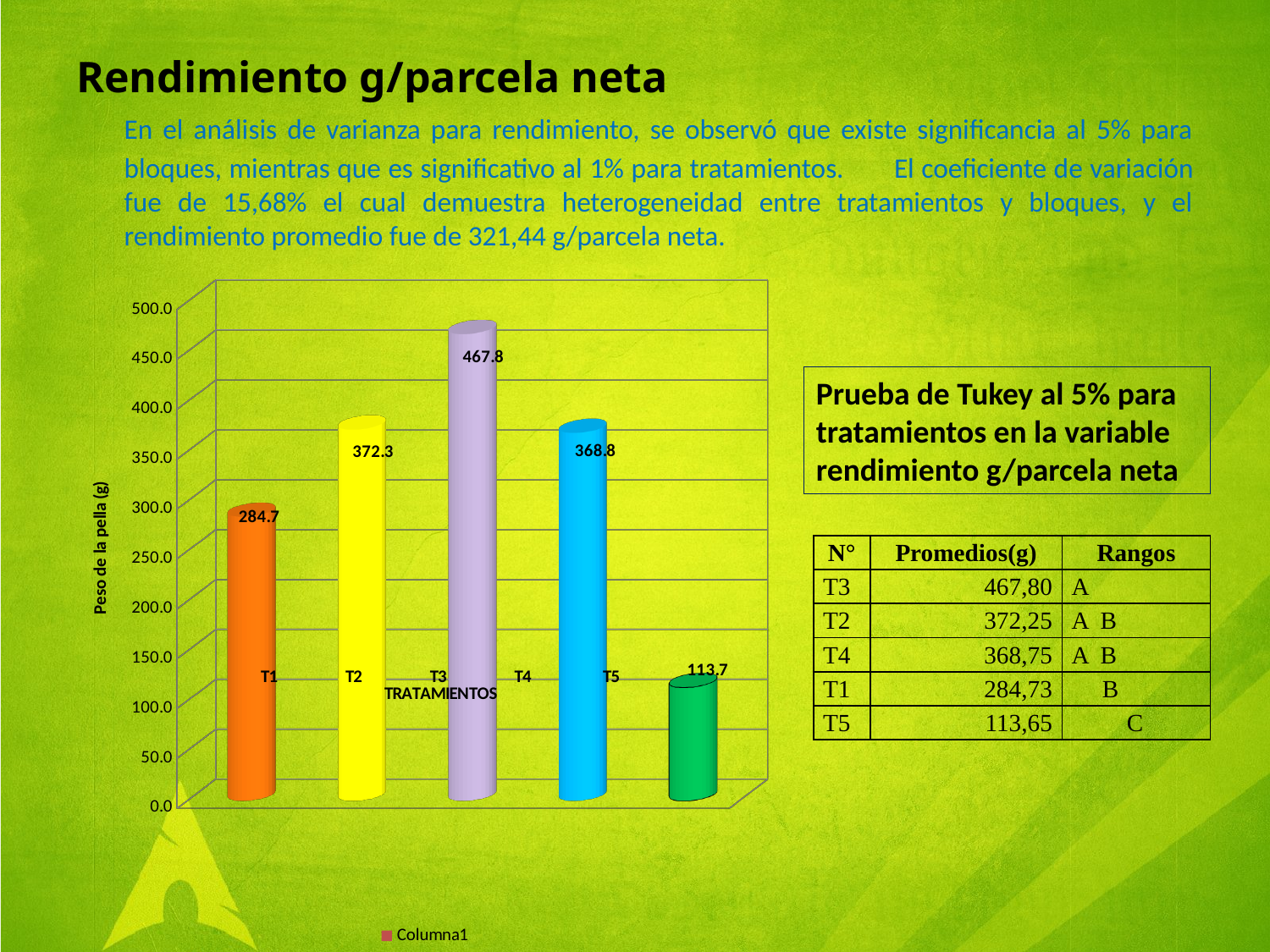
What is the difference between the values for T3 and T5? 354.1 What kind of chart is shown on the slide? bar chart Which is larger, the value for T1 or the value for T4? T4 What is the label of the y axis? Peso de la pella (g) What is the value for T1? 284.7 How many treatments are shown on the x axis? 5 What is the value for T5? 113.7 Which treatment has the lowest value? T5 What is the difference between the values for T2 and T1? 87.6 Which treatment has the highest value? T3 What is the value for T3? 467.8 Is the value for T2 greater or less than 350.0? greater